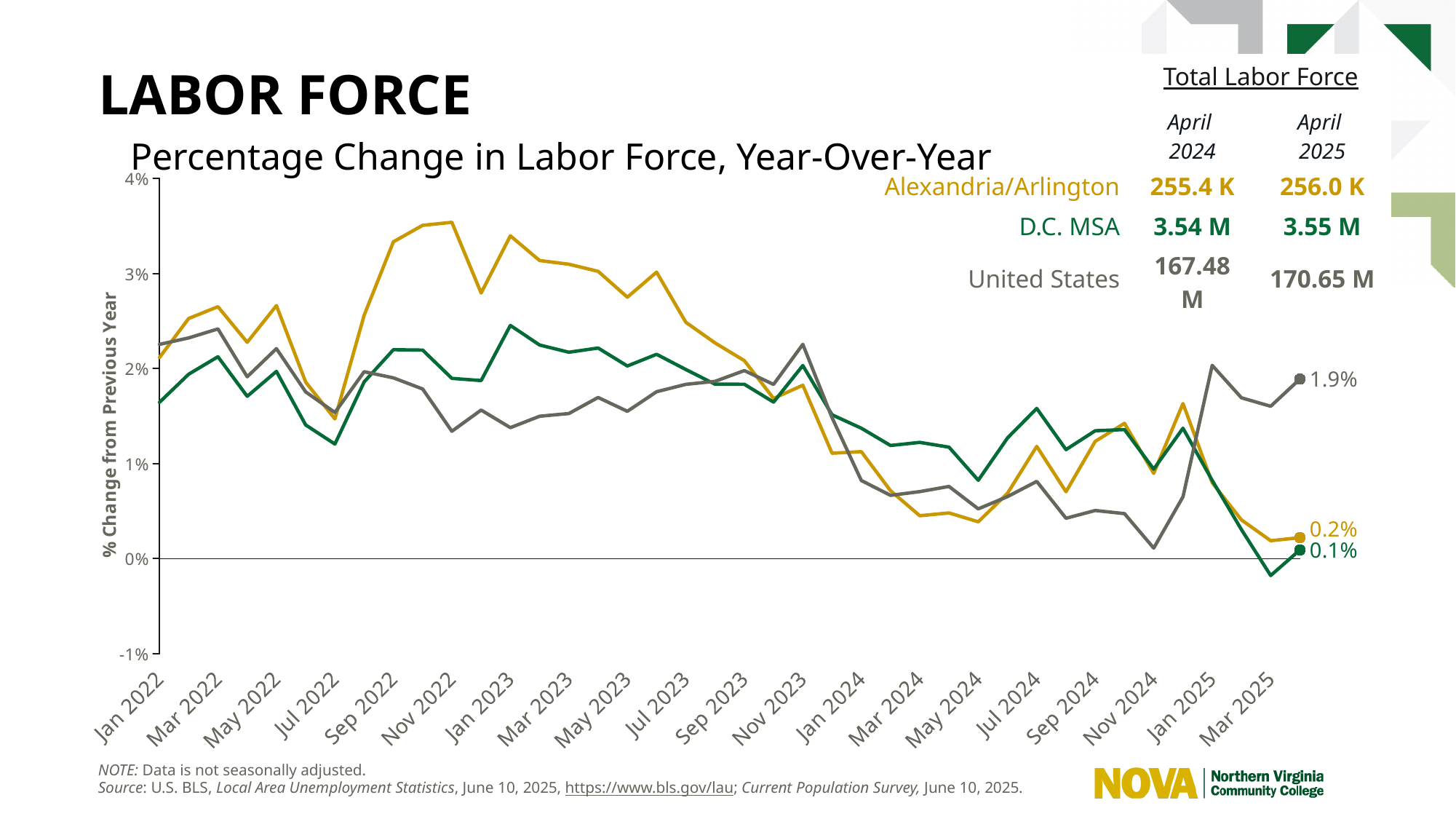
What is the difference between the final labeled values for the United States and Alexandria/Arlington? 1.7 percentage points What is the final labeled value for the Alexandria/Arlington series at the end of the chart? 0.2% Is the Alexandria/Arlington value in Oct 2022 greater or less than 3%? greater How many series are plotted on the chart? 3 What type of chart is shown on the slide? line chart Does the Alexandria/Arlington series generally rise or fall from Oct 2022 to Mar 2025? fall What is the final labeled value for the United States series at the end of the chart? 1.9% Which series has the lowest value at the end of the chart? D.C. MSA Which series has the highest value at the end of the chart? United States What is the final labeled value for the D.C. MSA series at the end of the chart? 0.1% What is the label on the vertical axis of the chart? % Change from Previous Year Is the D.C. MSA value in Mar 2025 greater or less than 0%? less